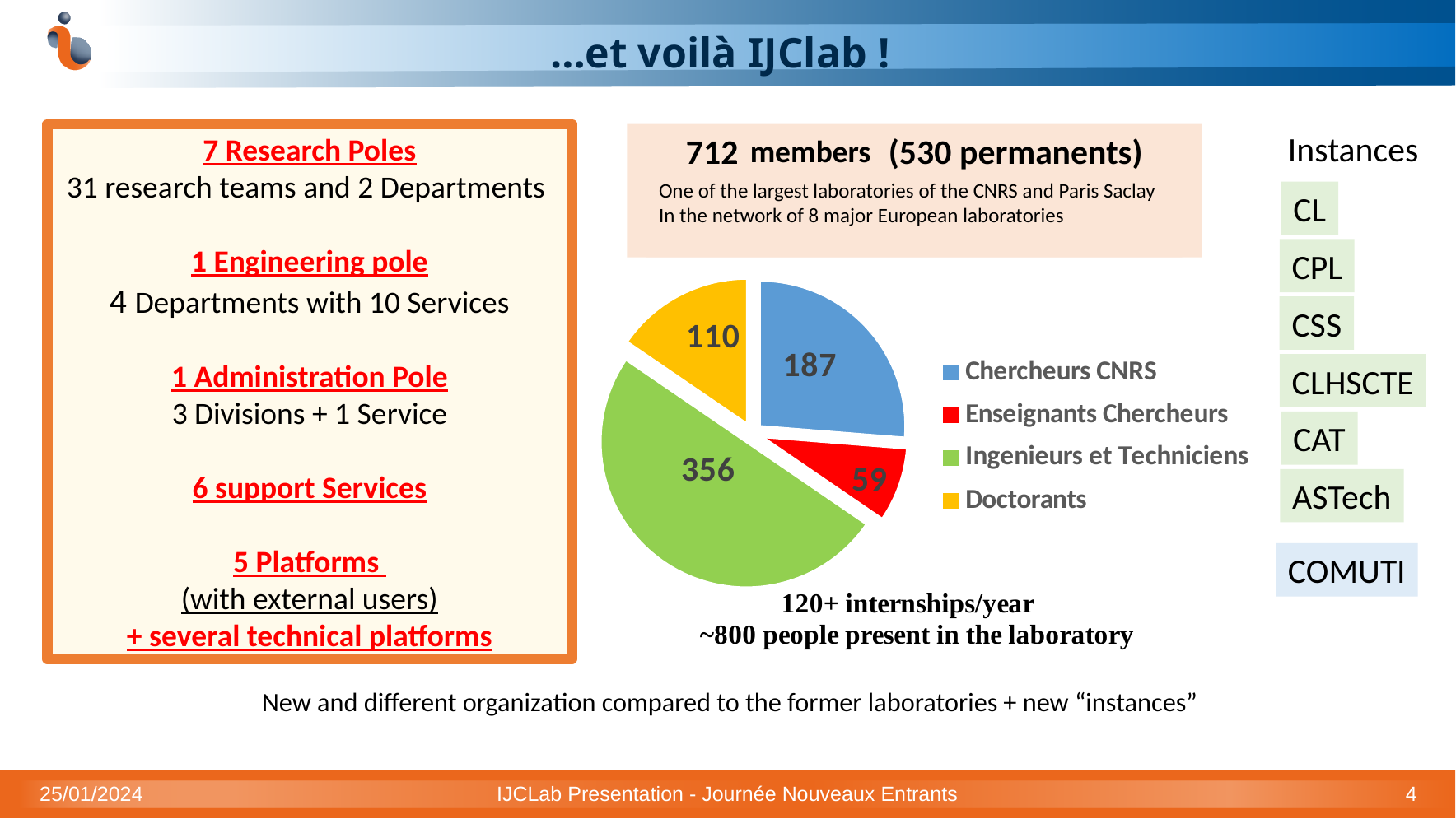
What is the value for Ingenieurs et Techniciens in the pie chart? 356 What share of the pie does Ingenieurs et Techniciens represent? 50% What kind of chart is shown on the slide? pie chart Which category has the largest slice in the pie chart? Ingenieurs et Techniciens What is the total of all the slices in the pie chart? 712 Which category has the smallest slice in the pie chart? Enseignants Chercheurs What is the value for Chercheurs CNRS in the pie chart? 187 What is the difference between the values for Ingenieurs et Techniciens and Chercheurs CNRS? 169 How many categories does the pie chart have? 4 What is the value for Enseignants Chercheurs in the pie chart? 59 What is the value for Doctorants in the pie chart? 110 Which is larger in the pie chart, Chercheurs CNRS or Doctorants? Chercheurs CNRS